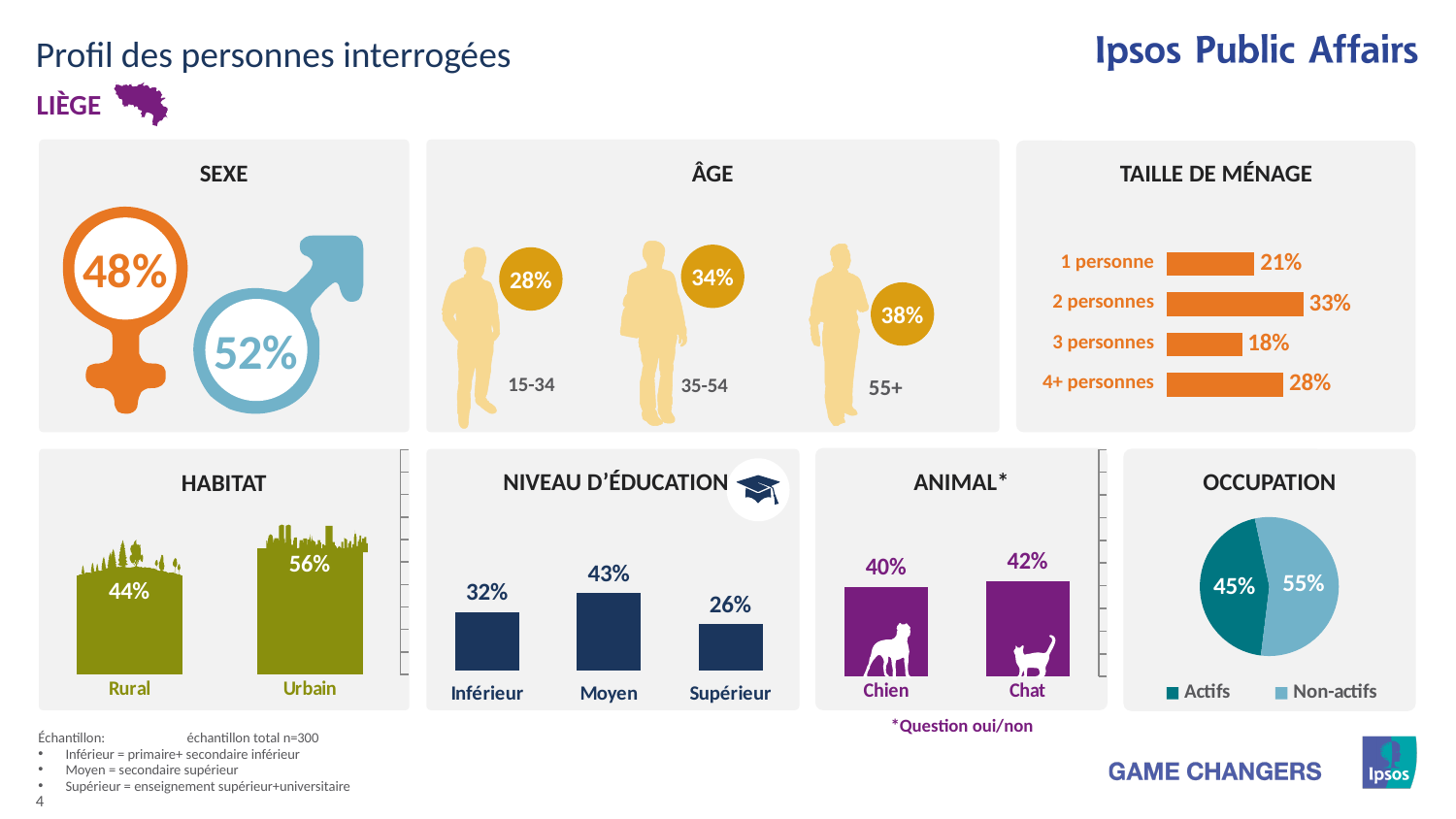
In the NIVEAU D'ÉDUCATION chart, what is the difference between Moyen and Supérieur? 17% In the ANIMAL chart, what is the value for Chien? 40% In the HABITAT chart, which is larger, Rural or Urbain? Urbain How many categories does the TAILLE DE MÉNAGE chart show? 4 In the TAILLE DE MÉNAGE chart, which household size has the lowest value? 3 personnes In the NIVEAU D'ÉDUCATION chart, which category has the highest value? Moyen In the TAILLE DE MÉNAGE chart, what is the difference between 4+ personnes and 1 personne? 7% In the HABITAT chart, what is the value for Urbain? 56% In the OCCUPATION pie chart, what share is Non-actifs? 55% How many entries does the legend of the OCCUPATION chart list? 2 What kind of chart is the NIVEAU D'ÉDUCATION chart? bar chart In the TAILLE DE MÉNAGE chart, what is the value for 2 personnes? 33%